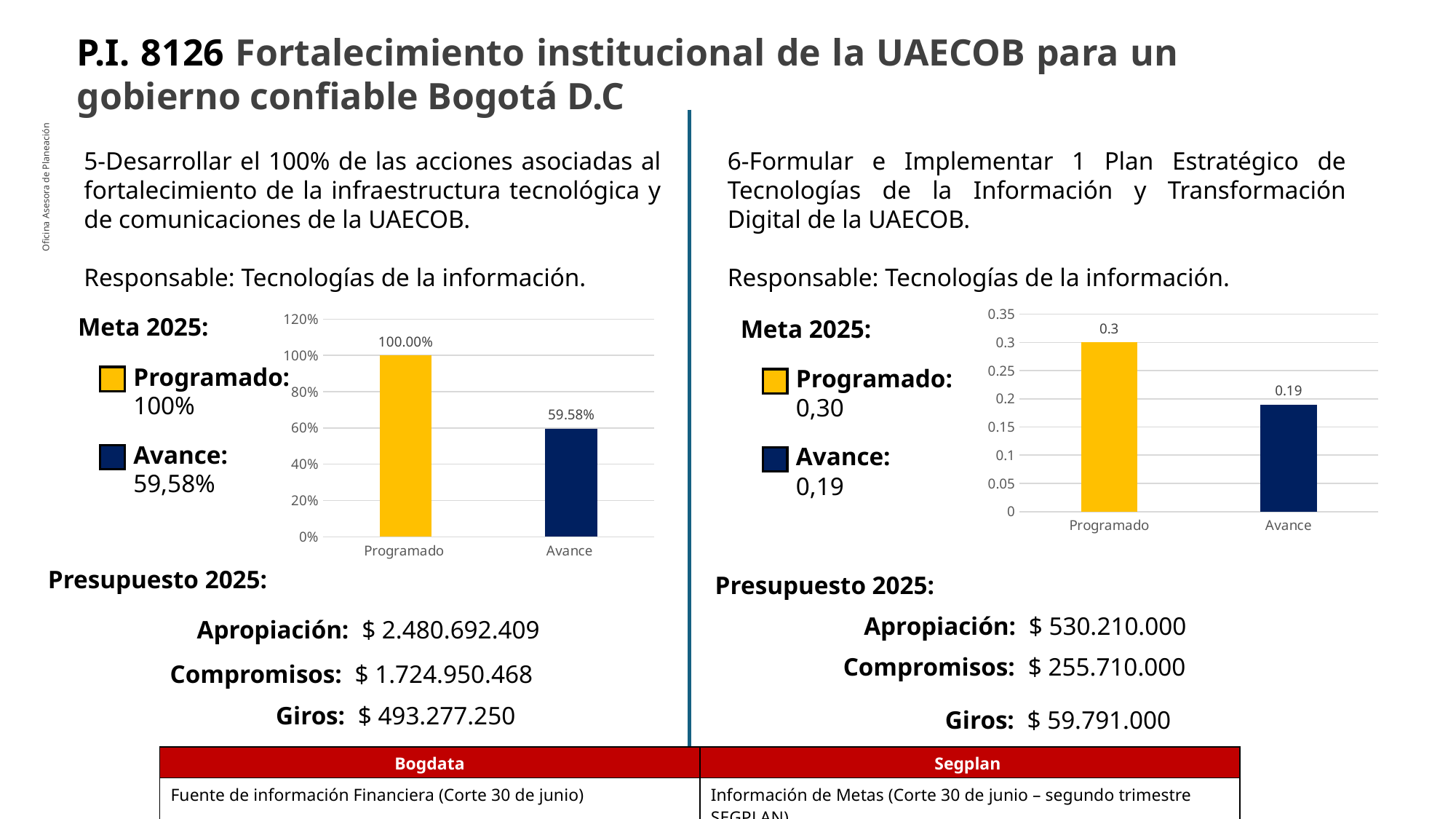
In the right chart, what is the difference between Programado and Avance? 0.11 In the right chart, is the value for Avance greater or less than 0.2? less In the left chart, what is the value for Avance? 59.58% In the left chart, what is the difference between Programado and Avance? 40.42% In the right chart, what is the value for Programado? 0.3 In the right chart, what is the value for Avance? 0.19 How many categories are shown in the left chart? 2 What kind of chart is the right chart? bar chart In the left chart, what is the value for Programado? 100.00% In the left chart, which category has the lowest value? Avance In the left chart, what colour is the Avance bar? dark blue In the right chart, which category has the highest value? Programado